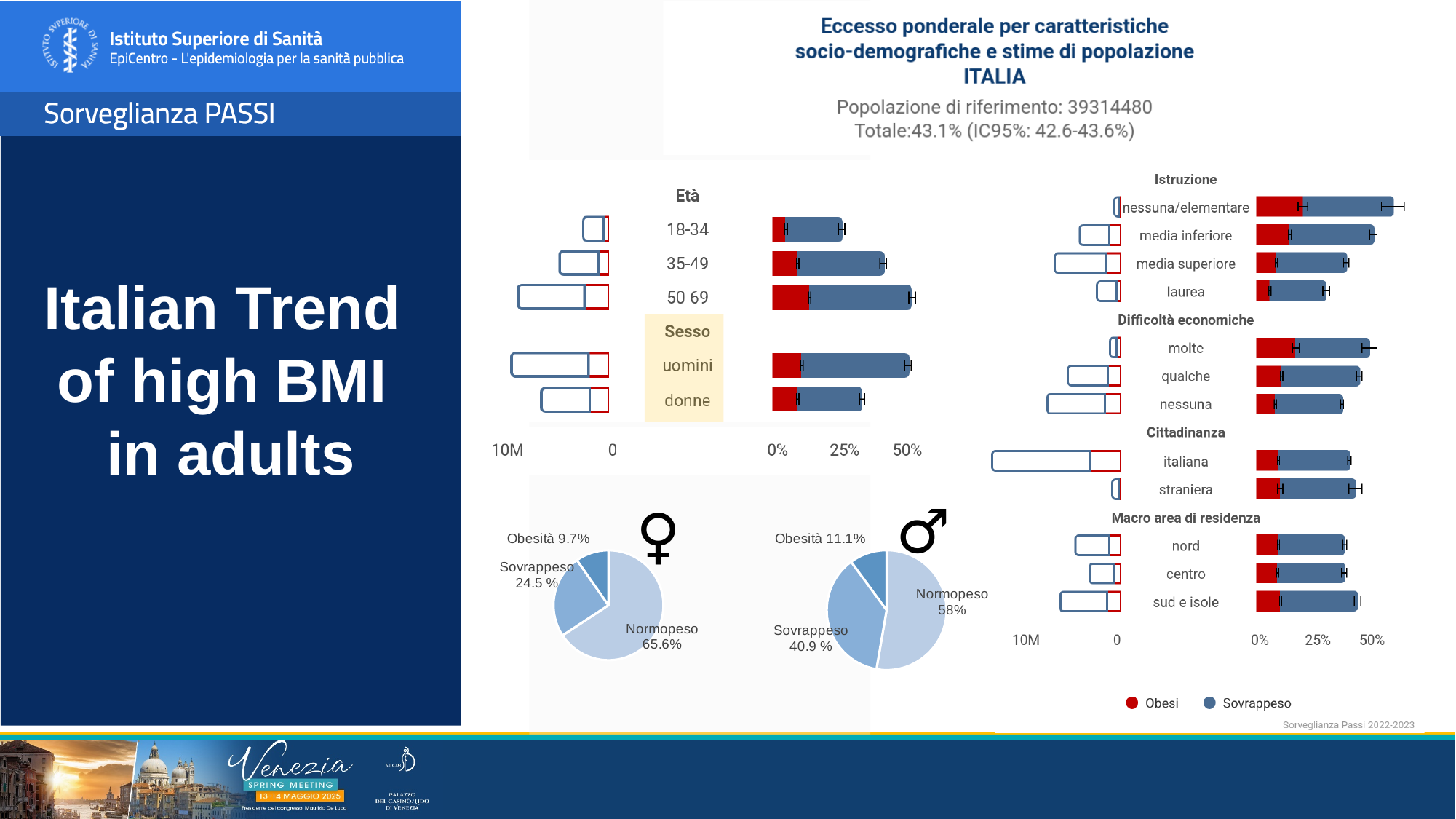
How many series does the legend at the bottom right list? 2 In the Età bar chart, is the total bar for 50-69 greater or less than 25%? greater In the Difficoltà economiche bar chart, which category has the longest bar? molte In the Istruzione bar chart, which education level has the shortest bar? laurea In the women's pie chart (♀), what is the Obesità share? 9.7% What is the difference in percentage points between the men's Obesità share (11.1%) and the women's Obesità share (9.7%)? 1.4 Comparing the two pie charts, which has the larger Obesità share, women (♀) or men (♂)? men (♂) In the men's pie chart (♂), what share is labelled Sovrappeso? 40.9 % In the Età bar chart, which age group has the longest bar for excess weight? 50-69 In the Sesso bar chart, which group has the longer bar, uomini or donne? uomini In the women's pie chart (♀), what share is labelled Normopeso? 65.6% What kind of chart is used for the Istruzione, Difficoltà economiche, Cittadinanza and Macro area di residenza data? bar chart